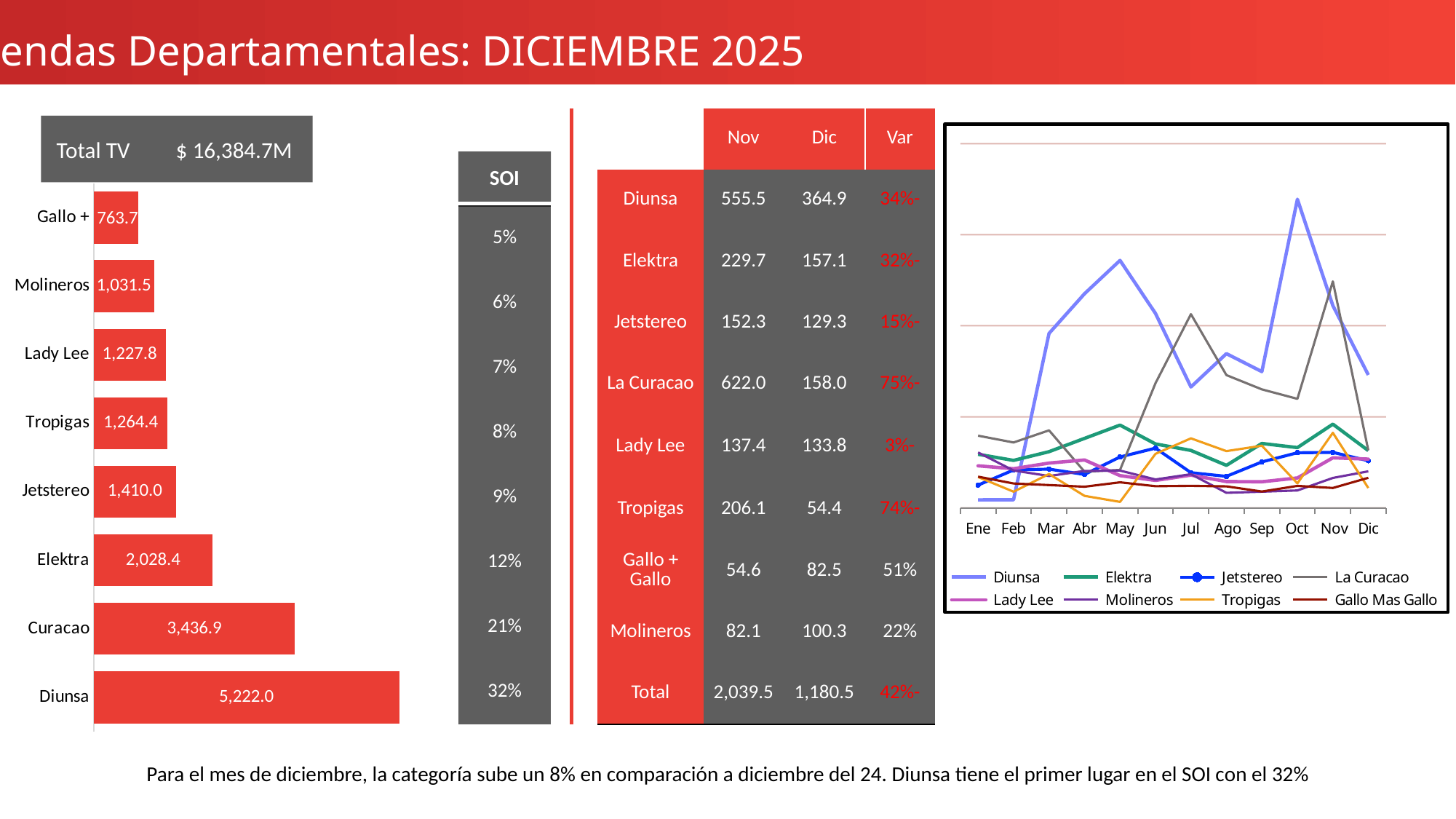
In the bar chart on the left, what is the difference between the values for Diunsa and Curacao? 1,785.1 What kind of chart is the chart on the left of the slide? Bar chart In the bar chart on the left, what is the value for Molineros? 1,031.5 In the bar chart on the left, which category has the lowest value? Gallo + In the line chart on the right, in which month does the Diunsa series reach its highest point? Oct How many series does the legend of the line chart on the right list? 8 In the bar chart on the left, which category has the highest value? Diunsa In the line chart on the right, does the La Curacao series rise or fall from Nov to Dic? Fall How many categories are shown in the bar chart on the left? 8 In the bar chart on the left, what is the value for Diunsa? 5,222.0 In the bar chart on the left, which is larger, the value for Jetstereo or the value for Tropigas? Jetstereo In the bar chart on the left, what is the value for Elektra? 2,028.4